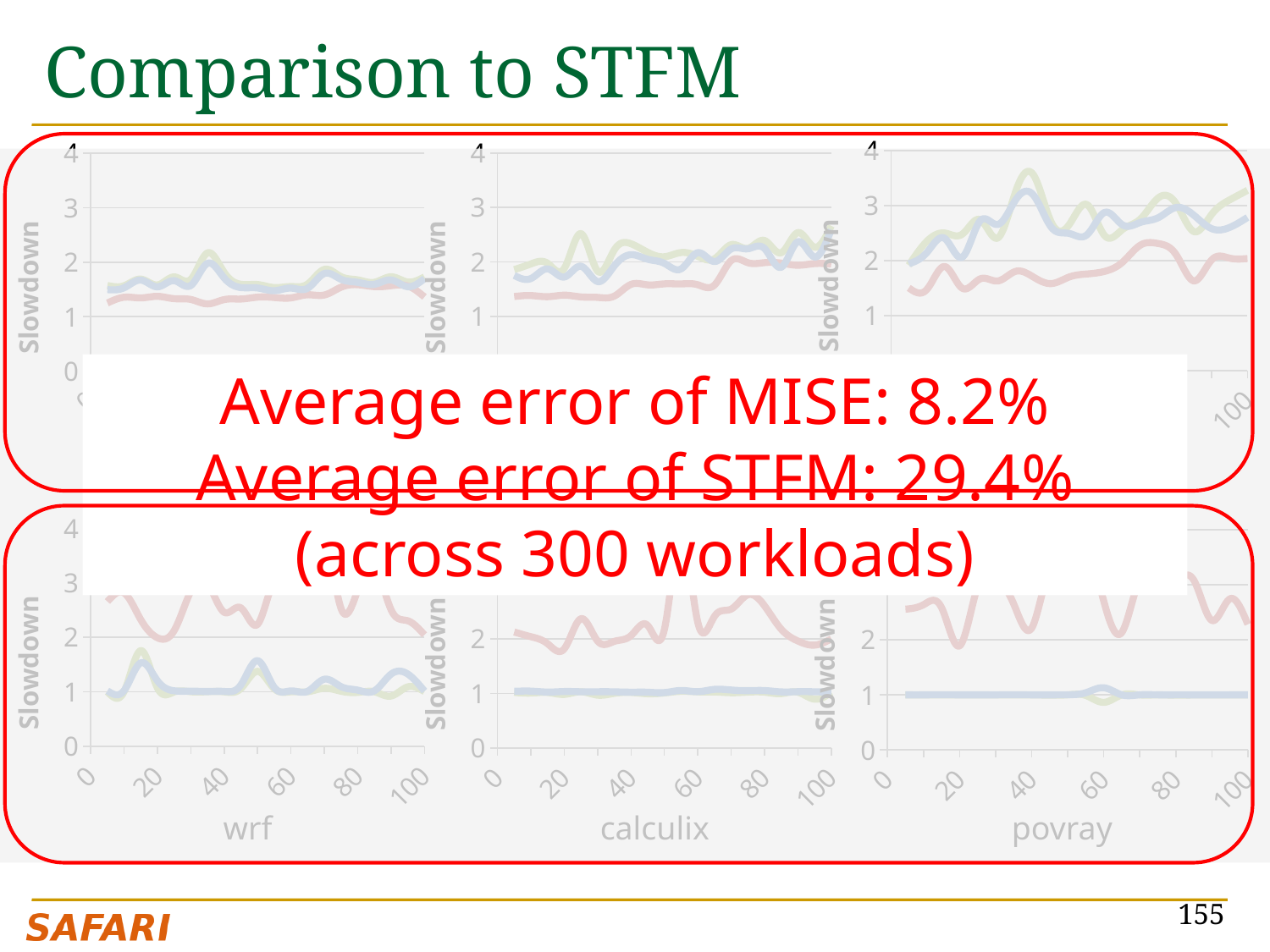
In the top-left chart, is the highest value of any line greater or less than 3? less In the top-right chart, is the peak of the green line greater or less than 3? greater What is the label on the y axis of the charts? Slowdown In the bottom-right chart (povray), is the blue line's value at x=40 greater or less than 2? less In the bottom-left chart (wrf), which line is higher at x=40, the red line or the blue line? red line What kind of chart is the bottom-left chart labelled wrf? line chart What is the category label under the bottom-middle chart? calculix In the top-right chart, which line is higher at x=40, the blue line or the red line? blue line How many charts are shown on the slide? 6 In the top-right chart, does the blue line generally rise or fall from x=0 to x=40? rise